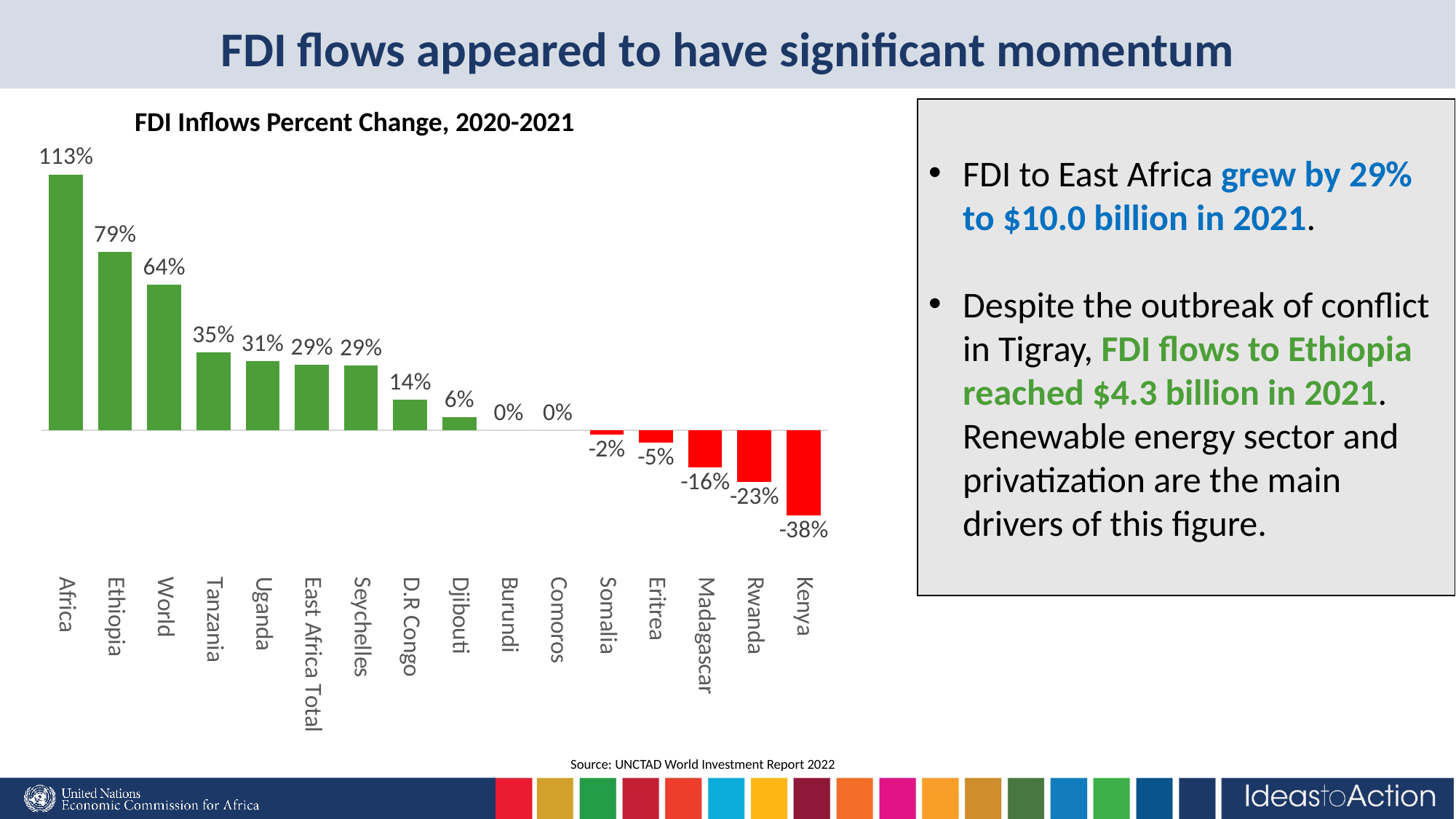
What is the FDI inflows percent change for Ethiopia? 79% Which has a larger FDI inflows percent change, Tanzania or Uganda? Tanzania Which category has the highest FDI inflows percent change? Africa How many categories are shown on the x axis of the chart? 16 Do the values rise or fall moving from left to right along the x axis? Fall What is the title of the chart? FDI Inflows Percent Change, 2020-2021 Which category has the lowest FDI inflows percent change? Kenya What colour are the bars with negative values? Red What is the FDI inflows percent change for Kenya? -38% What is the FDI inflows percent change for East Africa Total? 29% What kind of chart is shown on the slide? Bar chart What is the difference between the percent change for Africa and for World? 49 percentage points